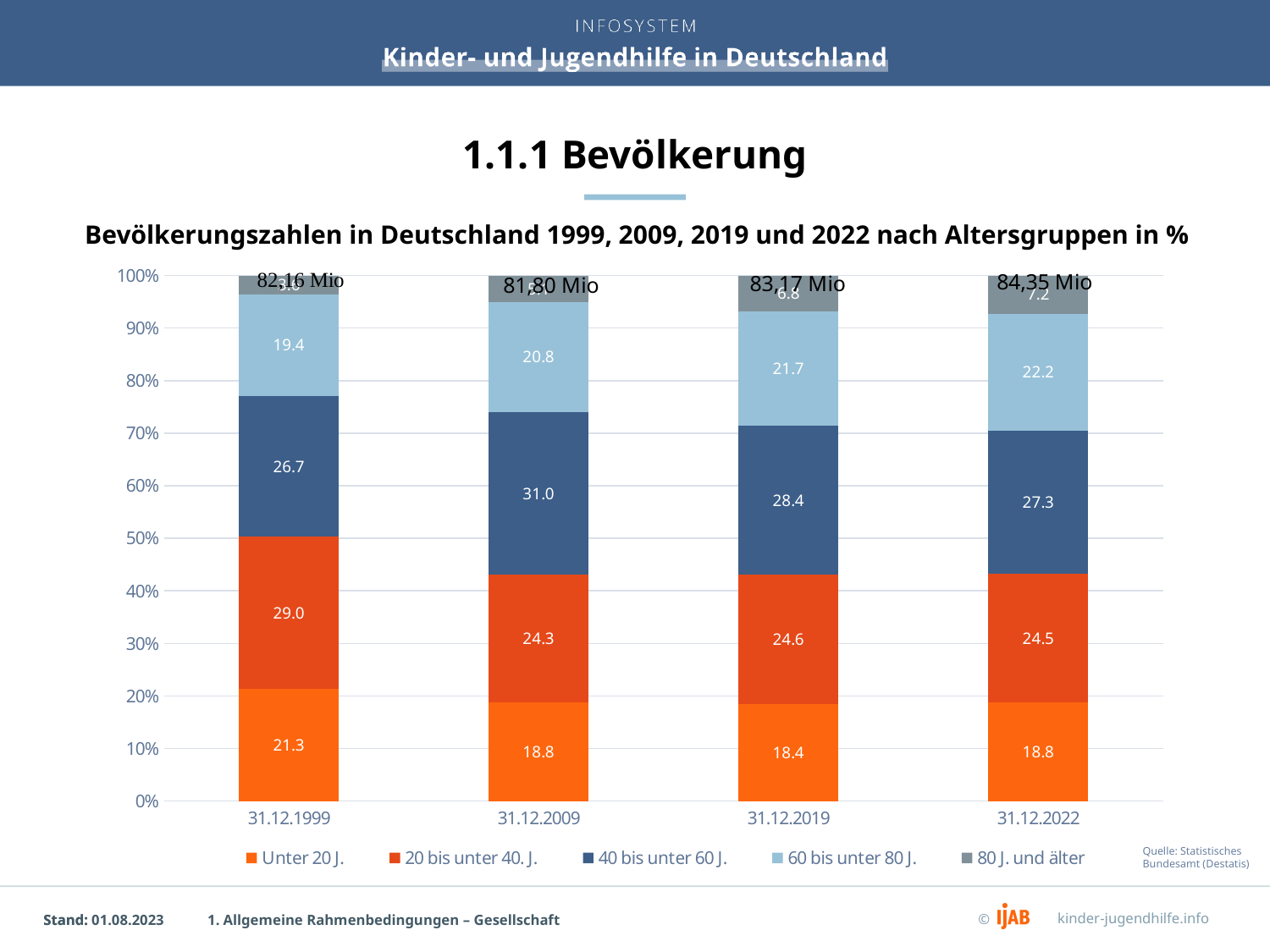
How many dates (categories) are shown on the x axis? 4 How many series does the legend list? 5 What is the value for '80 J. und älter' on 31.12.2022? 7.2 What is the value for '60 bis unter 80 J.' on 31.12.2019? 21.7 Is the value for '40 bis unter 60 J.' larger on 31.12.2009 or on 31.12.2022? 31.12.2009 Which date has the lowest value for '60 bis unter 80 J.'? 31.12.1999 Which date has the highest value for '20 bis unter 40. J.'? 31.12.1999 What kind of chart is shown on the slide? stacked bar chart What is the value for 'Unter 20 J.' on 31.12.1999? 21.3 What is the value for '40 bis unter 60 J.' on 31.12.2009? 31.0 What is the difference between the 'Unter 20 J.' values on 31.12.1999 and 31.12.2022? 2.5 What total population figure is printed above the bar for 31.12.2022? 84,35 Mio